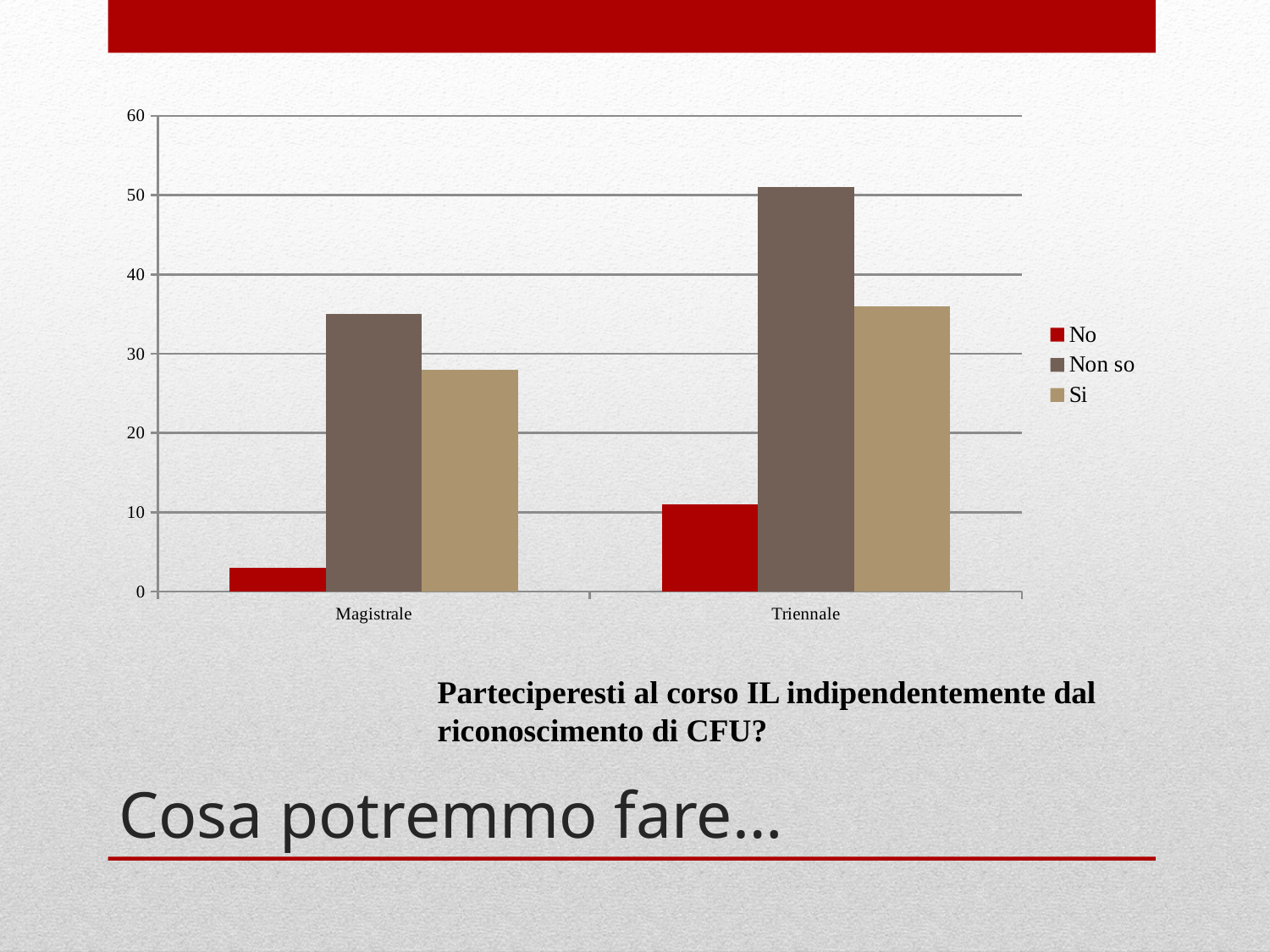
Is the 'Si' value for Triennale greater or less than 40? less Is the 'No' value for Magistrale greater or less than 10? less What kind of chart is shown on the slide? bar chart Which series has the lowest value for Magistrale? No How many series does the legend list? 3 How many categories are shown on the x axis? 2 Is the 'No' value for Triennale greater or less than 20? less Which is larger: the 'Si' value for Magistrale or the 'Si' value for Triennale? Triennale Which series has the highest value for Triennale? Non so Which legend entry is shown in red? No